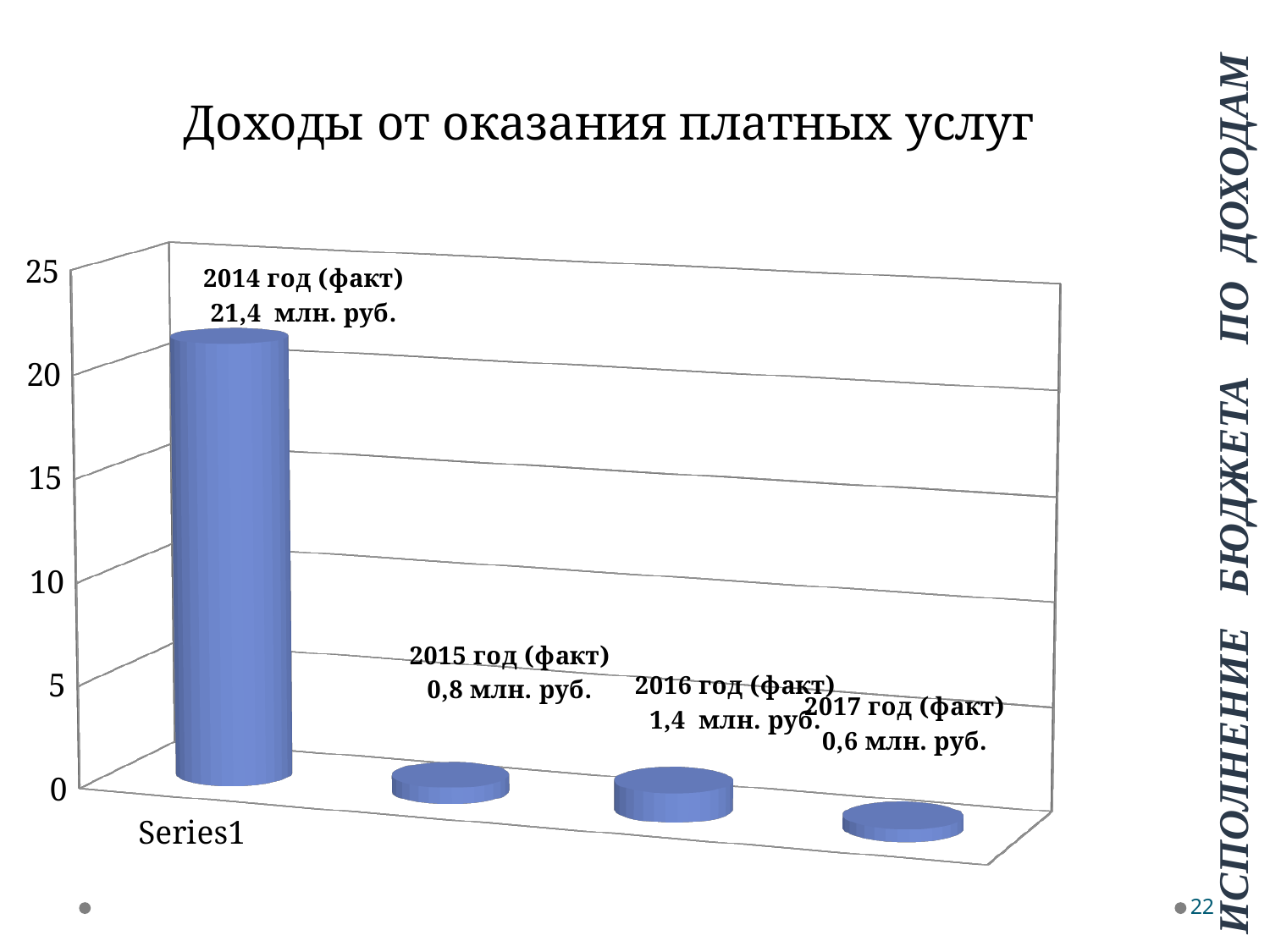
Is the value for 2014 год (факт) greater or less than 20? greater What is the value for 2017 год (факт)? 0,6 млн. руб. How many bars are shown in the chart? 4 Which year has the lowest income from paid services? 2017 год (факт) Which is larger, the value for 2015 год (факт) or 2016 год (факт)? 2016 год (факт) What is the difference between the values for 2014 год (факт) and 2016 год (факт)? 20,0 млн. руб. What type of chart is shown on the slide? bar chart What is the difference between the values for 2016 год (факт) and 2015 год (факт)? 0,6 млн. руб. Which year has the highest income from paid services? 2014 год (факт) What is the value for 2015 год (факт)? 0,8 млн. руб. What is the value for 2014 год (факт)? 21,4 млн. руб. What is the value for 2016 год (факт)? 1,4 млн. руб.